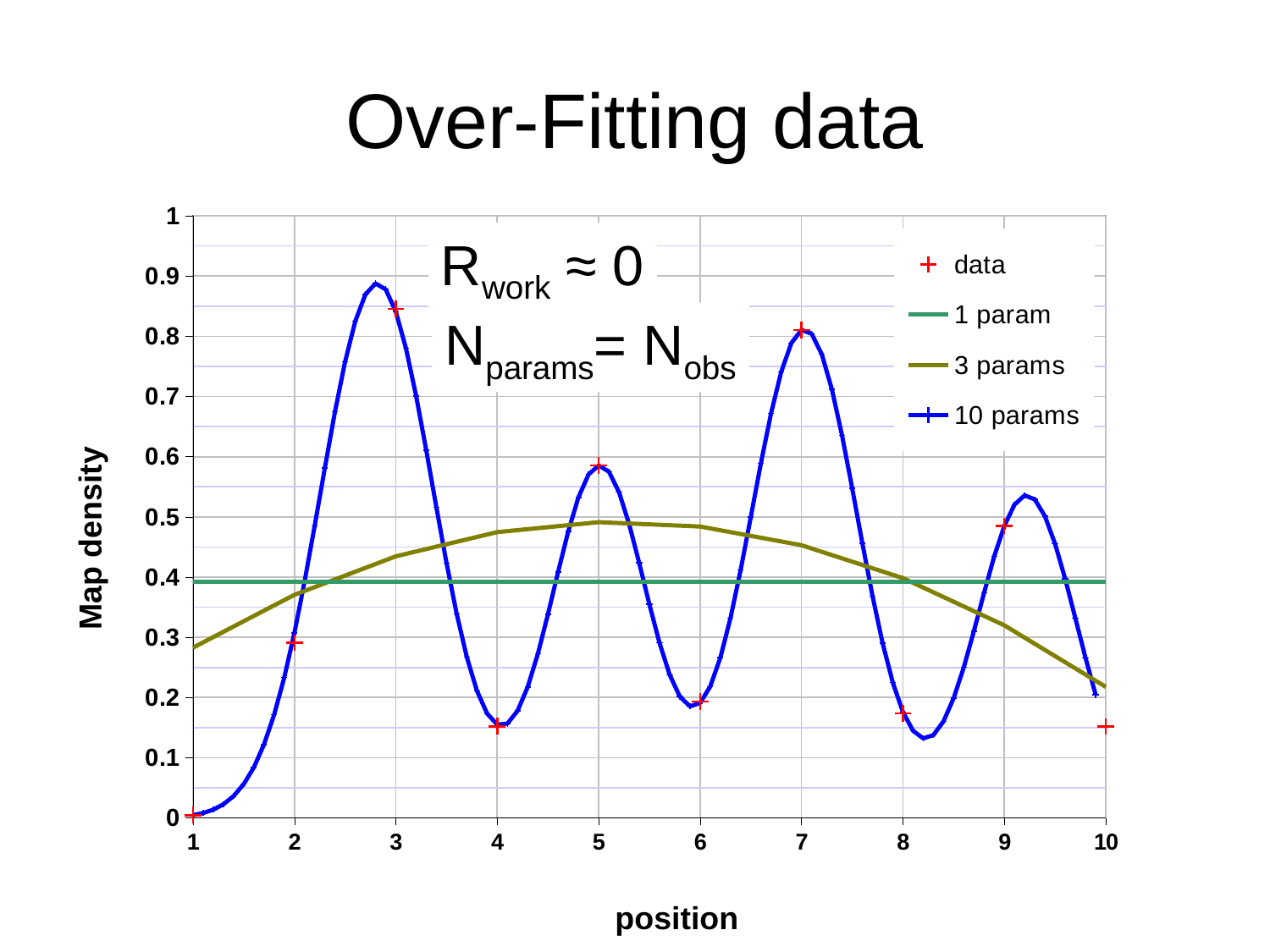
Is the 'data' value at position 5 greater or less than 0.5? greater How many data points (red crosses) are plotted for the 'data' series? 10 Does the '1 param' line rise, fall, or stay flat across the x axis? stay flat Which is larger, the 'data' value at position 5 or at position 6? position 5 How many series does the legend list? 4 Which is larger, the 'data' value at position 2 or at position 9? position 9 Is the 'data' value at position 3 greater or less than 0.8? greater What kind of chart is shown on the slide? line chart Is the 'data' value at position 4 greater or less than 0.2? less What is the label of the y axis? Map density At which position is the 'data' value lowest? 1 What is the title of the chart on the slide? Over-Fitting data